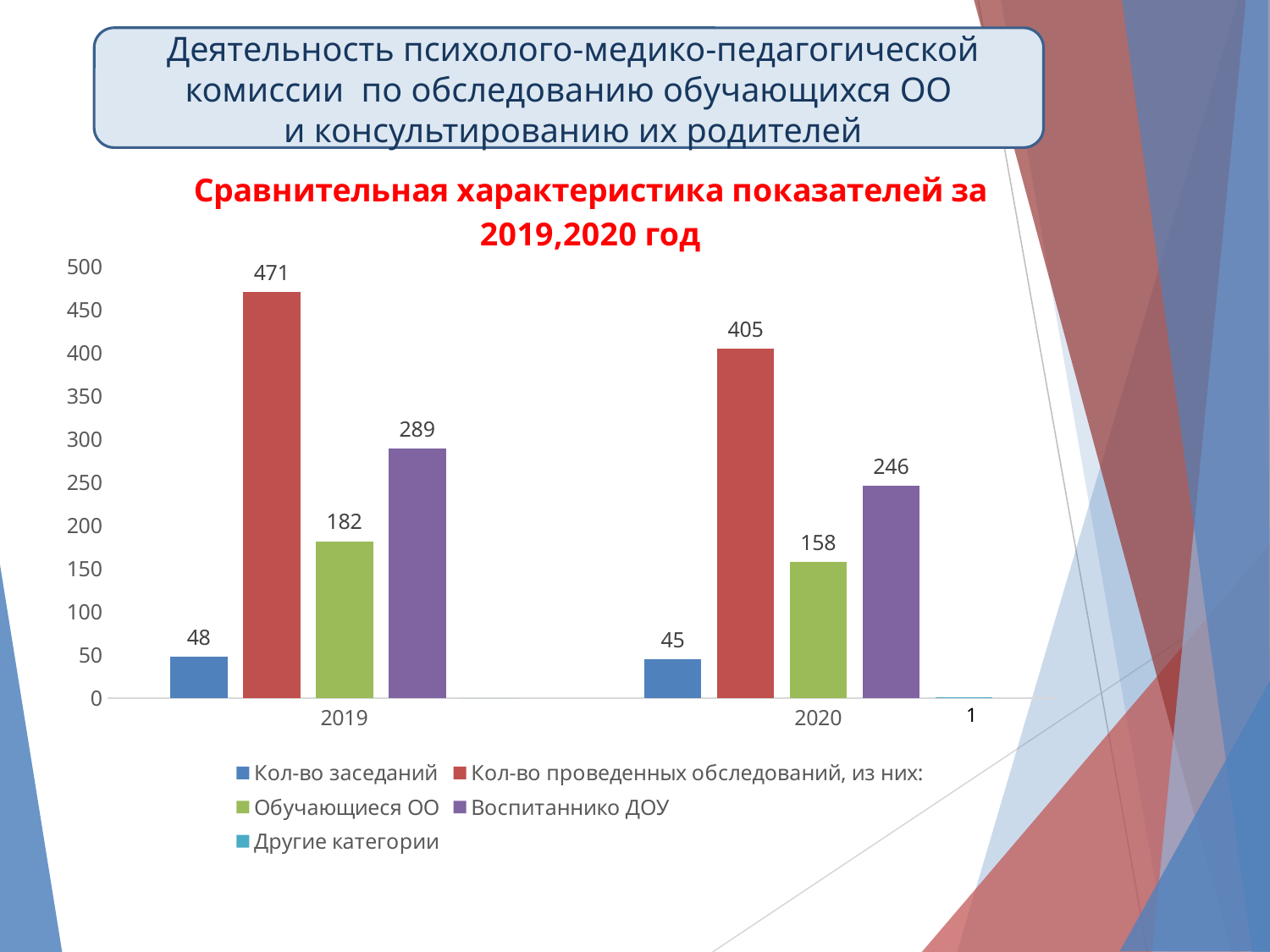
What is the value of "Обучающиеся ОО" for 2020? 158 Which is larger: "Воспитаннико ДОУ" in 2019 or in 2020? 2019 What is the value of "Кол-во заседаний" for 2020? 45 What type of chart is shown on the slide? bar chart What is the value of "Кол-во проведенных обследований, из них:" for 2019? 471 Which series has the highest value in 2020? Кол-во проведенных обследований, из них: What is the difference between the "Кол-во проведенных обследований, из них:" values for 2019 and 2020? 66 What is the value of "Другие категории" for 2020? 1 How many series does the legend list? 5 What is the title of the chart? Сравнительная характеристика показателей за 2019,2020 год What is the value of "Воспитаннико ДОУ" for 2019? 289